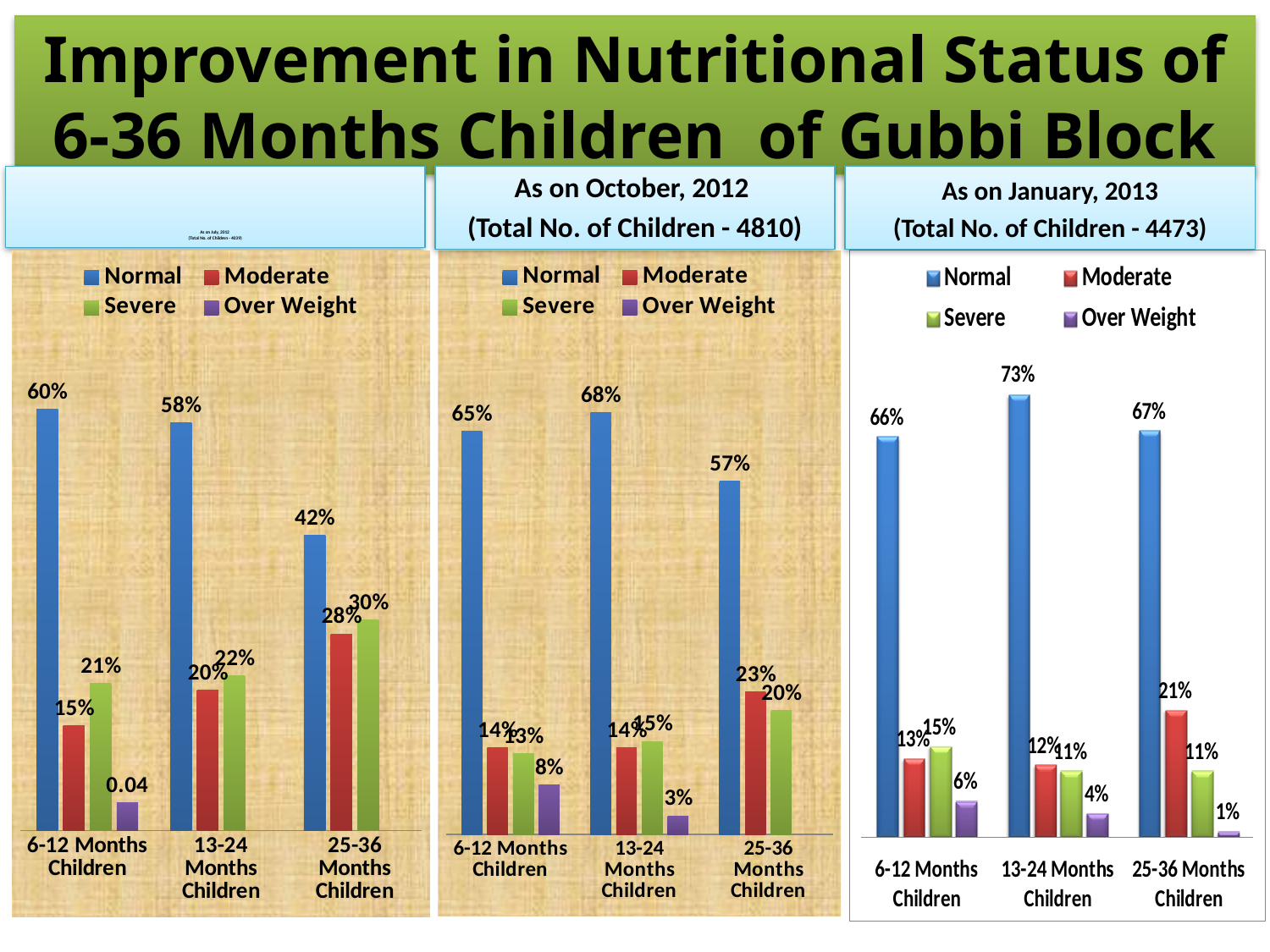
In the chart titled 'As on October, 2012', what is the Over Weight value for 6-12 Months Children? 8% How many series does the legend list in the chart titled 'As on January, 2013'? 4 In the chart titled 'As on October, 2012', what is the difference between the Normal values for 13-24 Months Children and 25-36 Months Children? 11% What total number of children is stated in the title of the chart 'As on October, 2012'? 4810 In the leftmost chart, is the Moderate value for 25-36 Months Children larger or smaller than the Severe value for the same group? smaller In the chart titled 'As on October, 2012', which age group has the highest Normal value? 13-24 Months Children What kind of chart is the chart titled 'As on January, 2013'? bar chart In the leftmost chart, do the Moderate values rise or fall from 6-12 Months Children to 25-36 Months Children? rise In the chart titled 'As on January, 2013', which age group has the lowest Over Weight value? 25-36 Months Children How many age-group categories are shown on the x axis of the chart titled 'As on October, 2012'? 3 In the chart titled 'As on January, 2013', what is the Normal value for 13-24 Months Children? 73% In the leftmost chart, what is the Severe value for 25-36 Months Children? 30%